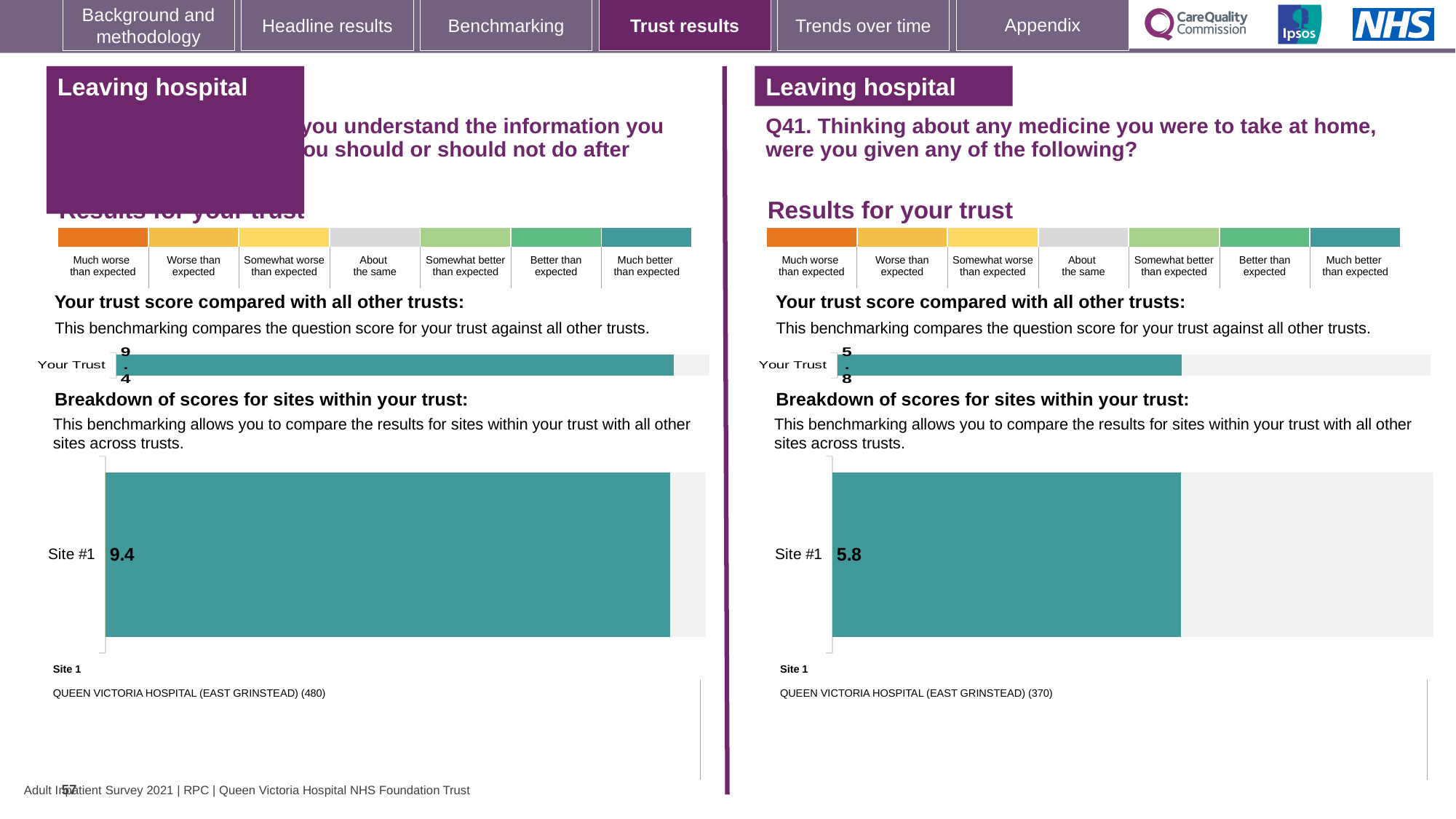
On the left half of the slide, what is the value shown for Your Trust in the 'Your trust score compared with all other trusts' chart? 9.4 On the right half of the slide (Q41), what is the score shown for Site #1 in the breakdown of scores for sites within your trust? 5.8 What is the name of Site 1 listed below the breakdown chart on the right half of the slide (Q41)? QUEEN VICTORIA HOSPITAL (EAST GRINSTEAD) (370) What is the difference between the Site #1 score on the left half of the slide and the Site #1 score on the right half (Q41)? 3.6 On the left half of the slide, what is the score shown for Site #1 in the breakdown of scores for sites within your trust? 9.4 How many sites are shown in the breakdown of scores chart on the right half of the slide (Q41)? 1 What kind of chart is used to show the Site #1 score on the right half of the slide (Q41)? Bar chart How many sites are shown in the breakdown of scores chart on the left half of the slide? 1 Is the Your Trust score on the right half of the slide (Q41) greater or less than the Your Trust score on the left half? less What colour is the Site #1 bar in the breakdown chart on the left half of the slide? Teal Which is larger: the Site #1 score on the left half of the slide or the Site #1 score on the right half (Q41)? Left half (9.4) On the right half of the slide (Q41), what is the value shown for Your Trust in the 'Your trust score compared with all other trusts' chart? 5.8